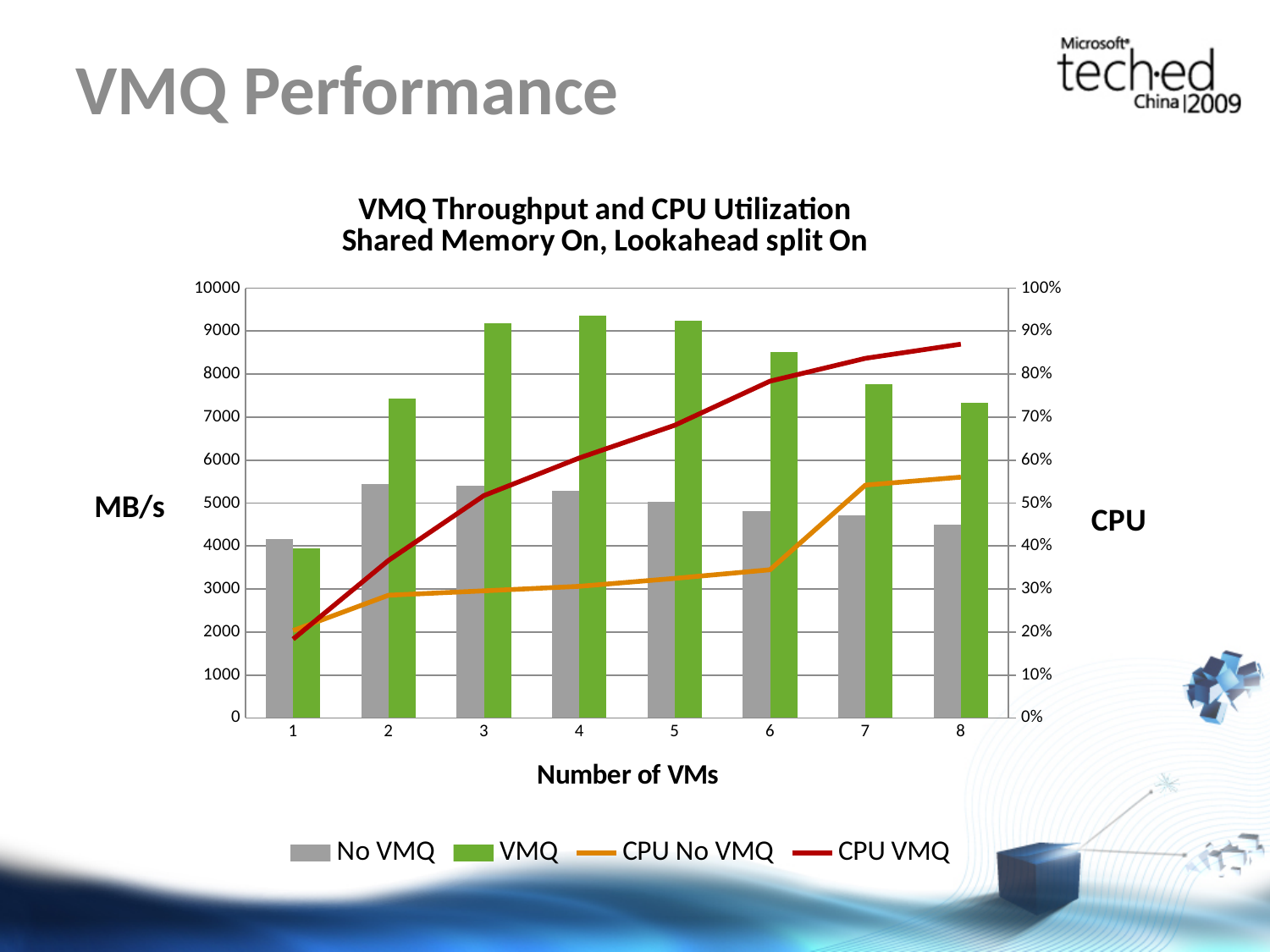
Is the No VMQ throughput value at 8 VMs greater or less than 5000? less What is the title of the x axis? Number of VMs Is the CPU VMQ value at 8 VMs greater or less than 80%? greater At 8 VMs, which line is higher: CPU No VMQ or CPU VMQ? CPU VMQ Is the CPU No VMQ value at 6 VMs greater or less than 40%? less What kind of chart is shown on the slide? A combination bar and line chart At which number of VMs is the VMQ throughput bar lowest? 1 Does the CPU VMQ line rise or fall as the number of VMs increases? Rises How many Number of VMs categories are plotted on the x axis? 8 At 3 VMs, which bar is taller: No VMQ or VMQ? VMQ How many series does the legend list? 4